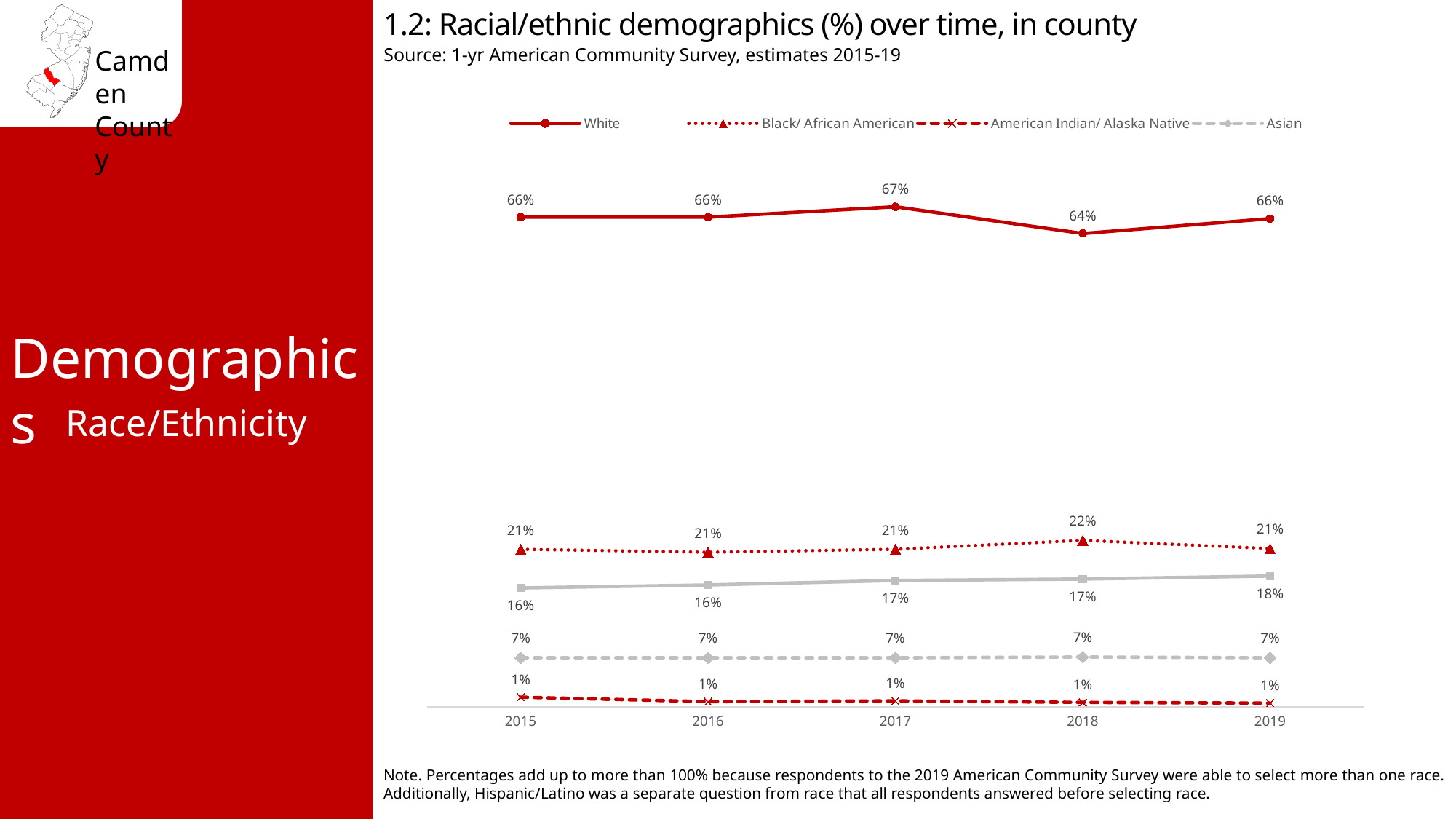
Does the Asian percentage rise, fall, or stay flat from 2015 to 2019? stays flat In which year was the White percentage highest? 2017 What kind of chart is shown on the slide? line chart By how many percentage points did the White share fall from 2017 to 2018? 3 percentage points What was the White percentage in 2018? 64% What was the American Indian/ Alaska Native percentage in 2019? 1% What data source is cited under the chart title? 1-yr American Community Survey, estimates 2015-19 What was the Black/ African American percentage in 2018? 22% In 2015, which was larger: the White percentage or the Black/ African American percentage? White In which year was the White percentage lowest? 2018 What was the Asian percentage in 2017? 7% How many years are shown on the x axis? 5